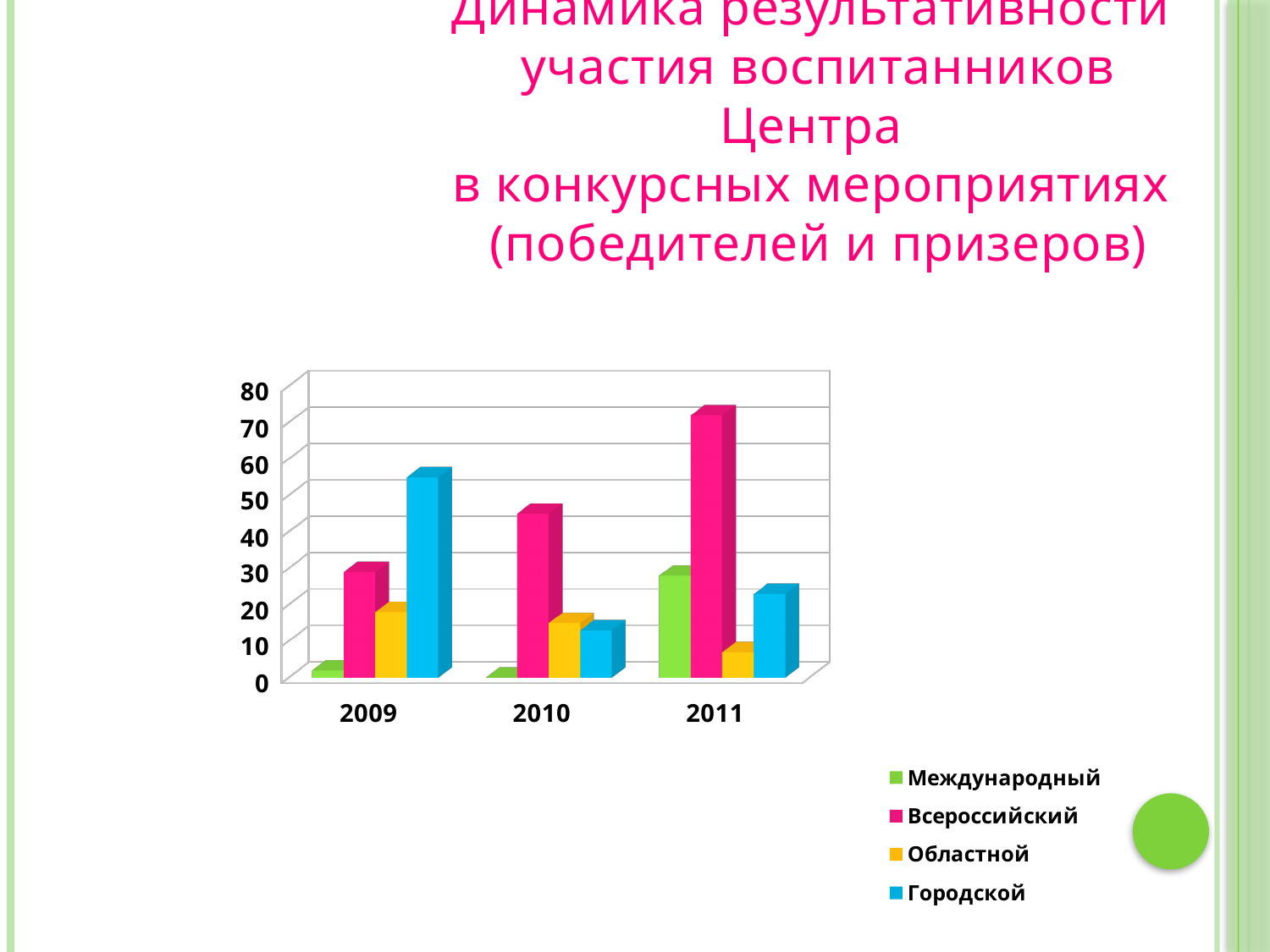
What kind of chart is shown on the slide? bar chart Which series has the highest value in 2009? Городской In 2009, which is larger: Городской or Всероссийский? Городской How many years are shown on the x axis of the chart? 3 In 2011, which is larger: Международный or Областной? Международный Do the values for Всероссийский rise or fall from 2009 to 2011? rise Is the value for Всероссийский in 2011 greater or less than 60? greater Is the value for Областной in 2011 greater or less than 20? less In which year is the value for Всероссийский the highest? 2011 Which series has the highest value in 2011? Всероссийский Which series has the lowest value in 2009? Международный How many series does the chart's legend list? 4